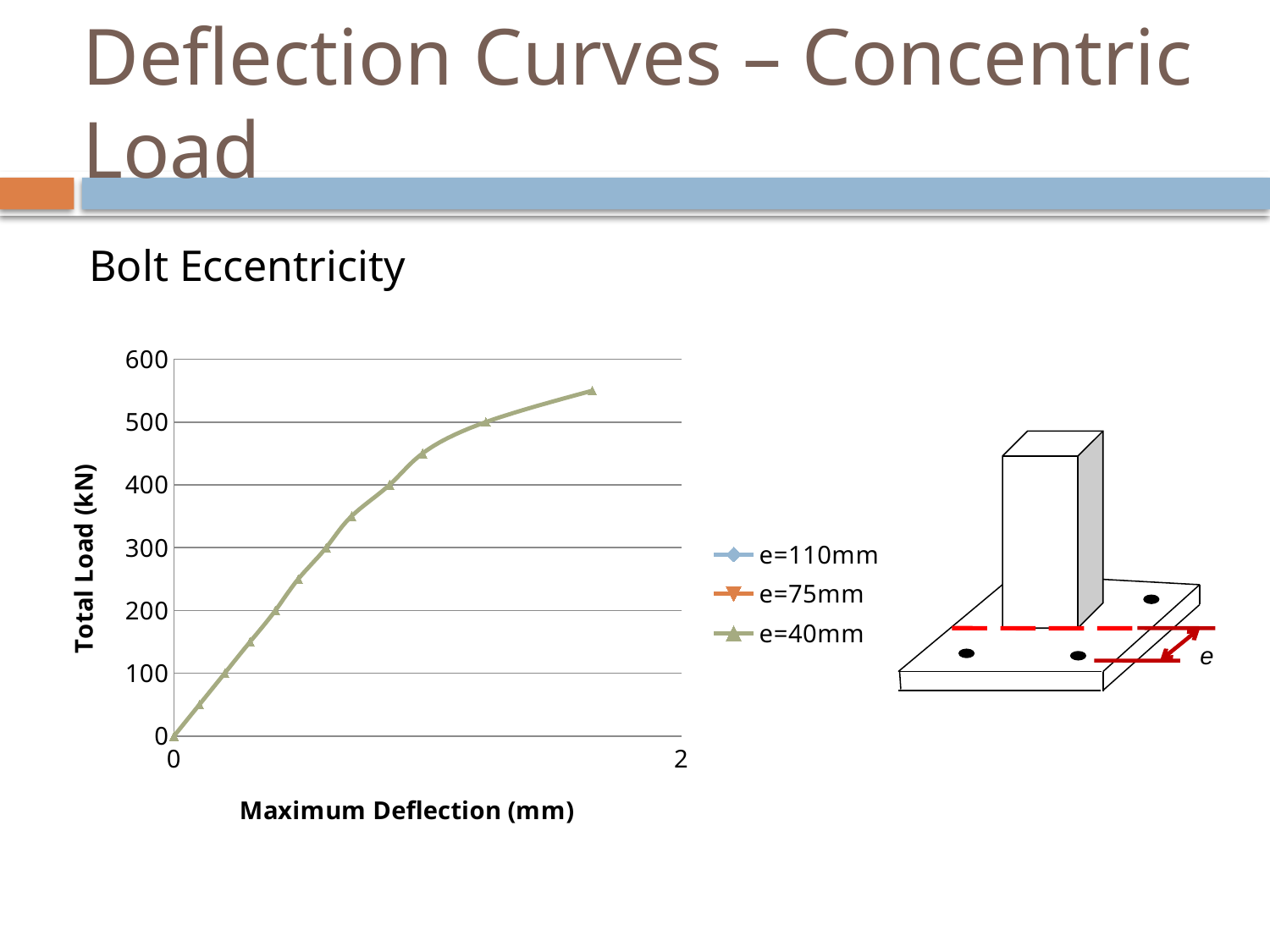
How many series does the legend list? 3 Which series are listed in the legend? e=110mm, e=75mm, e=40mm Is the highest total load reached by the e=40mm curve greater or less than 500? greater What is the title of the vertical axis? Total Load (kN) What is the total load at the first plotted point of the e=40mm curve? 0 How many data points are plotted on the e=40mm curve? 12 Does the total load rise or fall as maximum deflection increases along the x axis? rise What kind of chart is shown on the slide? line chart Is the highest total load reached by the e=40mm curve greater or less than 600? less What is the highest value shown on the Maximum Deflection (mm) axis? 2 What is the highest value shown on the Total Load (kN) axis? 600